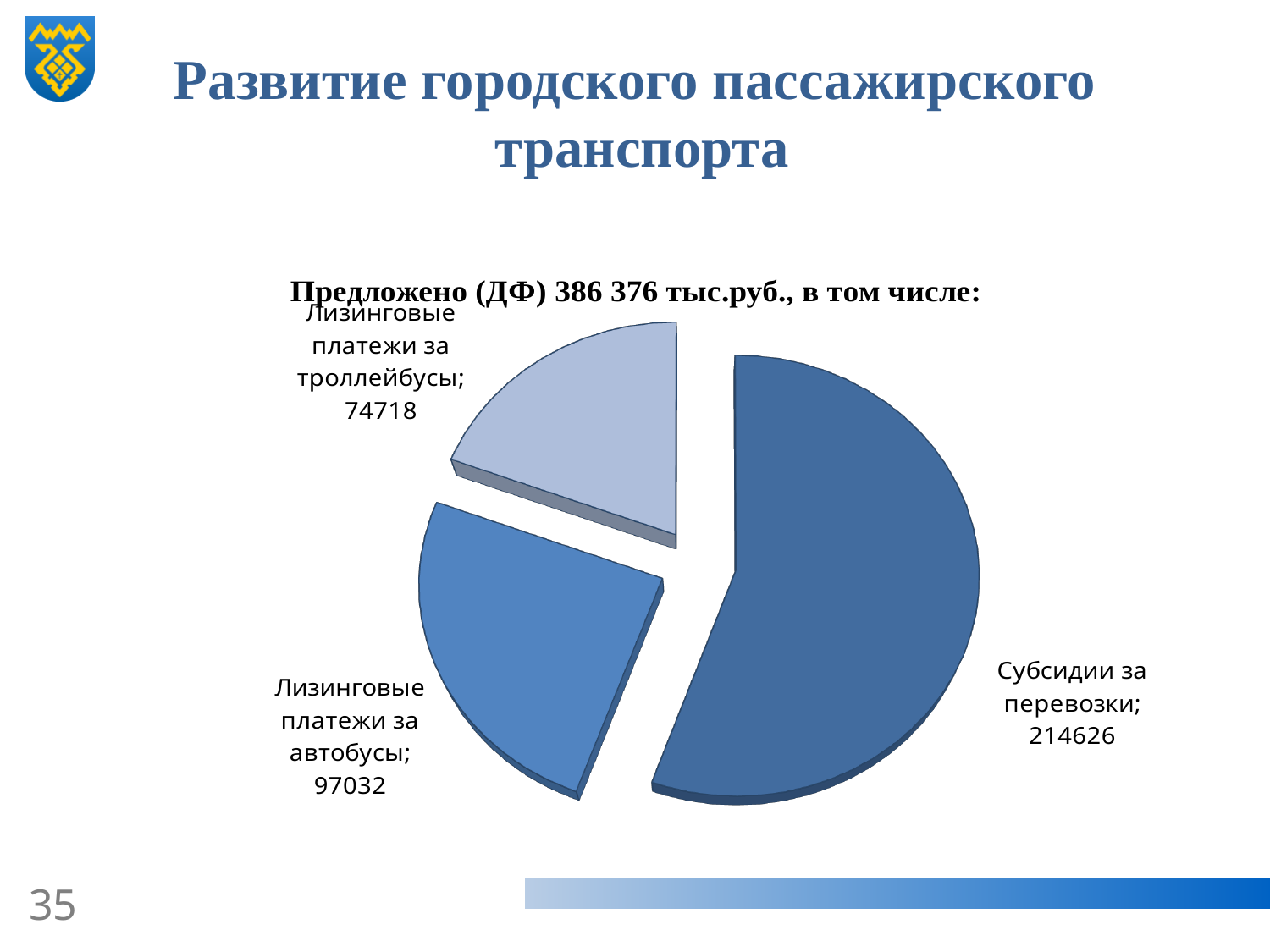
What is the difference between Лизинговые платежи за автобусы and Лизинговые платежи за троллейбусы? 22314 What is the value for Лизинговые платежи за автобусы? 97032 Which is larger: Лизинговые платежи за автобусы or Лизинговые платежи за троллейбусы? Лизинговые платежи за автобусы What is the difference between Субсидии за перевозки and Лизинговые платежи за автобусы? 117594 What total amount (in тыс.руб.) does the chart title say was proposed? 386 376 Which category has the smallest slice of the pie? Лизинговые платежи за троллейбусы What is the title of the chart? Предложено (ДФ) 386 376 тыс.руб., в том числе: Which category has the largest slice of the pie? Субсидии за перевозки What is the value for Субсидии за перевозки? 214626 How many slices does the pie chart have? 3 What kind of chart is shown on the slide? pie chart What is the value for Лизинговые платежи за троллейбусы? 74718